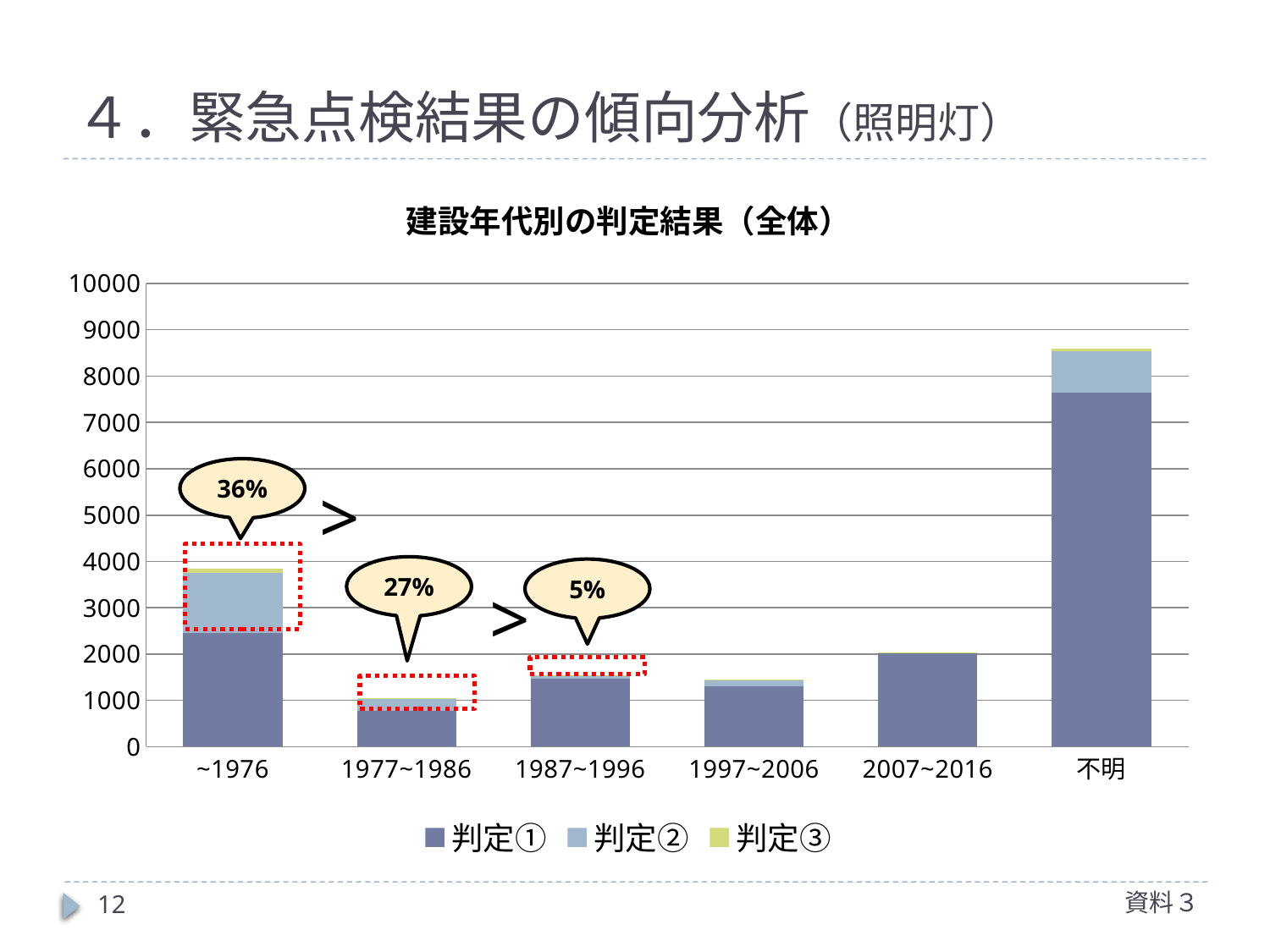
Is the total for 1977~1986 greater or less than 2000? less Which category has the shortest stacked bar? 1977~1986 How many construction-period categories are shown on the x axis? 6 What is the title of the chart? 建設年代別の判定結果（全体） Which category has the tallest stacked bar? 不明 Is the 判定① value for 不明 greater or less than 7000? greater Which stacked bar is taller, ~1976 or 1987~1996? ~1976 What kind of chart is shown on the slide? stacked bar chart Is the total for 不明 greater or less than 8000? greater What percentage is shown in the callout above the ~1976 bar? 36% How many series does the legend list? 3